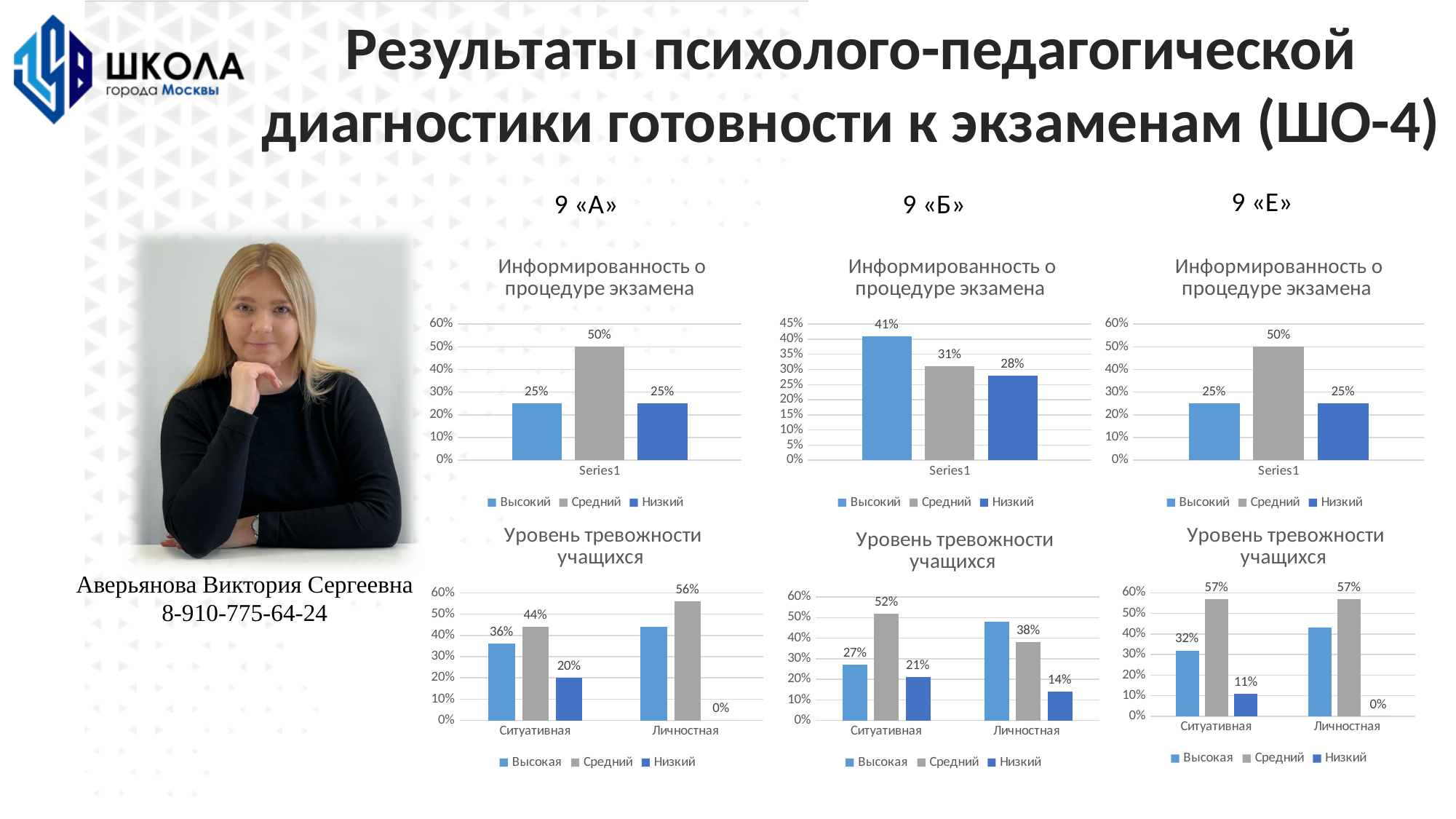
In the 9 «Б» chart 'Уровень тревожности учащихся', which is larger for Ситуативная: Высокая or Средний? Средний How many series does the legend list in the 9 «А» chart 'Уровень тревожности учащихся'? 3 How many categories are shown on the x axis of the 9 «Б» chart 'Уровень тревожности учащихся'? 2 In the 9 «А» chart 'Уровень тревожности учащихся', what is the Средний value for Ситуативная? 44% In the 9 «А» chart 'Информированность о процедуре экзамена', what is the value for Средний? 50% In the 9 «Б» chart 'Информированность о процедуре экзамена', what is the difference between Высокий and Низкий? 13% In the 9 «Е» chart 'Уровень тревожности учащихся', what is the Низкий value for Ситуативная? 11% In the 9 «Б» chart 'Уровень тревожности учащихся', what is the Низкий value for Личностная? 14% In the 9 «Б» chart 'Информированность о процедуре экзамена', what is the value for Высокий? 41% What kind of chart is the 9 «Е» chart 'Информированность о процедуре экзамена'? Bar chart In the 9 «Б» chart 'Информированность о процедуре экзамена', which level has the highest value? Высокий In the 9 «Е» chart 'Уровень тревожности учащихся', is the Высокая value for Личностная greater or less than 30%? greater